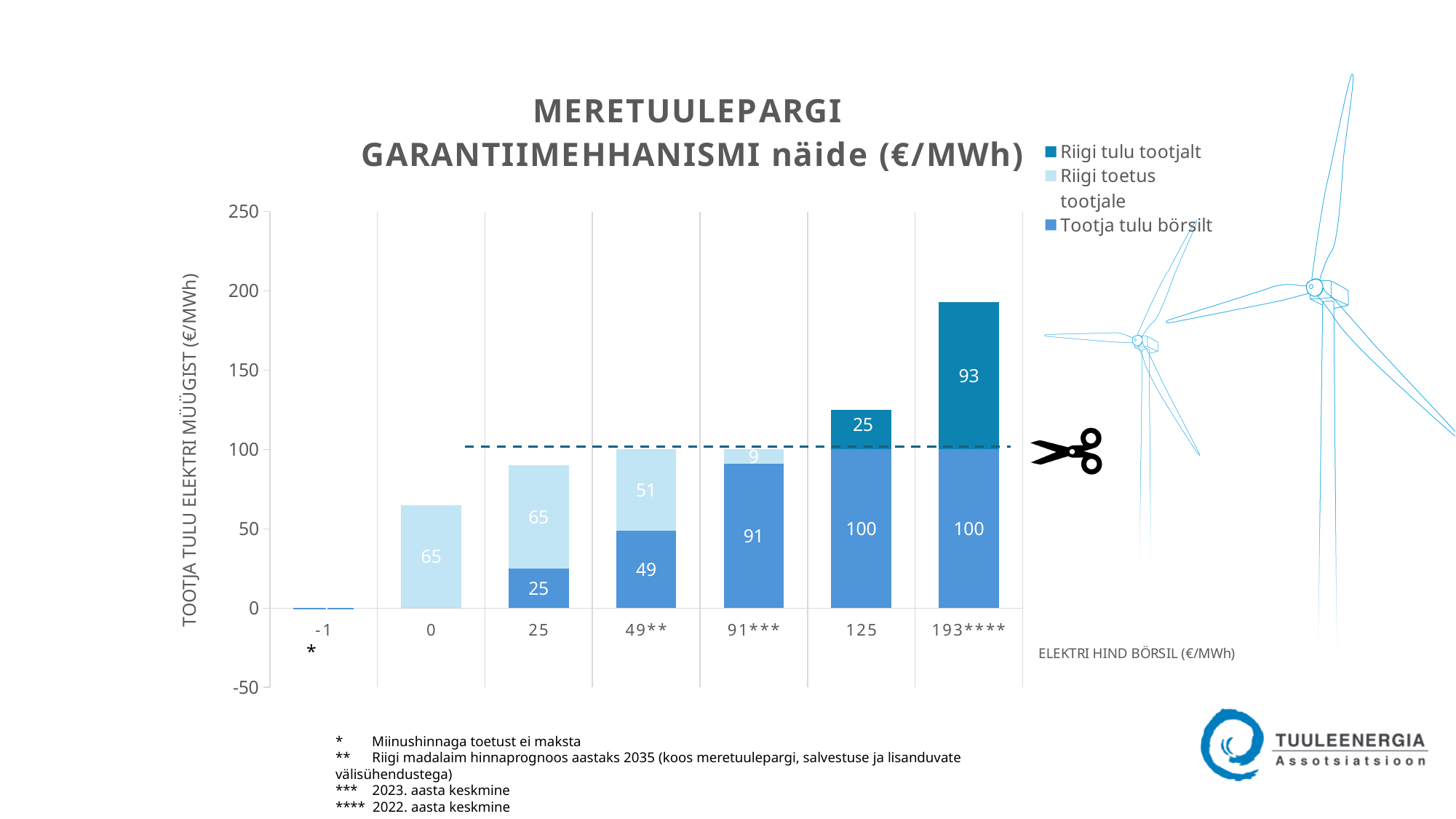
What is the value of 'Riigi tulu tootjalt' for the category 193****? 93 What is the value of 'Riigi toetus tootjale' for the category 91***? 9 Is 'Tootja tulu börsilt' for the category 25 larger or smaller than 'Riigi toetus tootjale' for the same category? Smaller What kind of chart is shown on the slide? Stacked bar chart How many categories are shown on the x axis? 7 Which category has the highest total stacked bar? 193**** What is the value of 'Riigi toetus tootjale' for the category 0? 65 What is the value of 'Tootja tulu börsilt' for the category 49**? 49 What is the difference between 'Riigi tulu tootjalt' for 193**** and for 125? 68 What is the total of the stacked bar for the category 125? 125 What is the total of the stacked bar for the category 25? 90 How many series does the legend list? 3